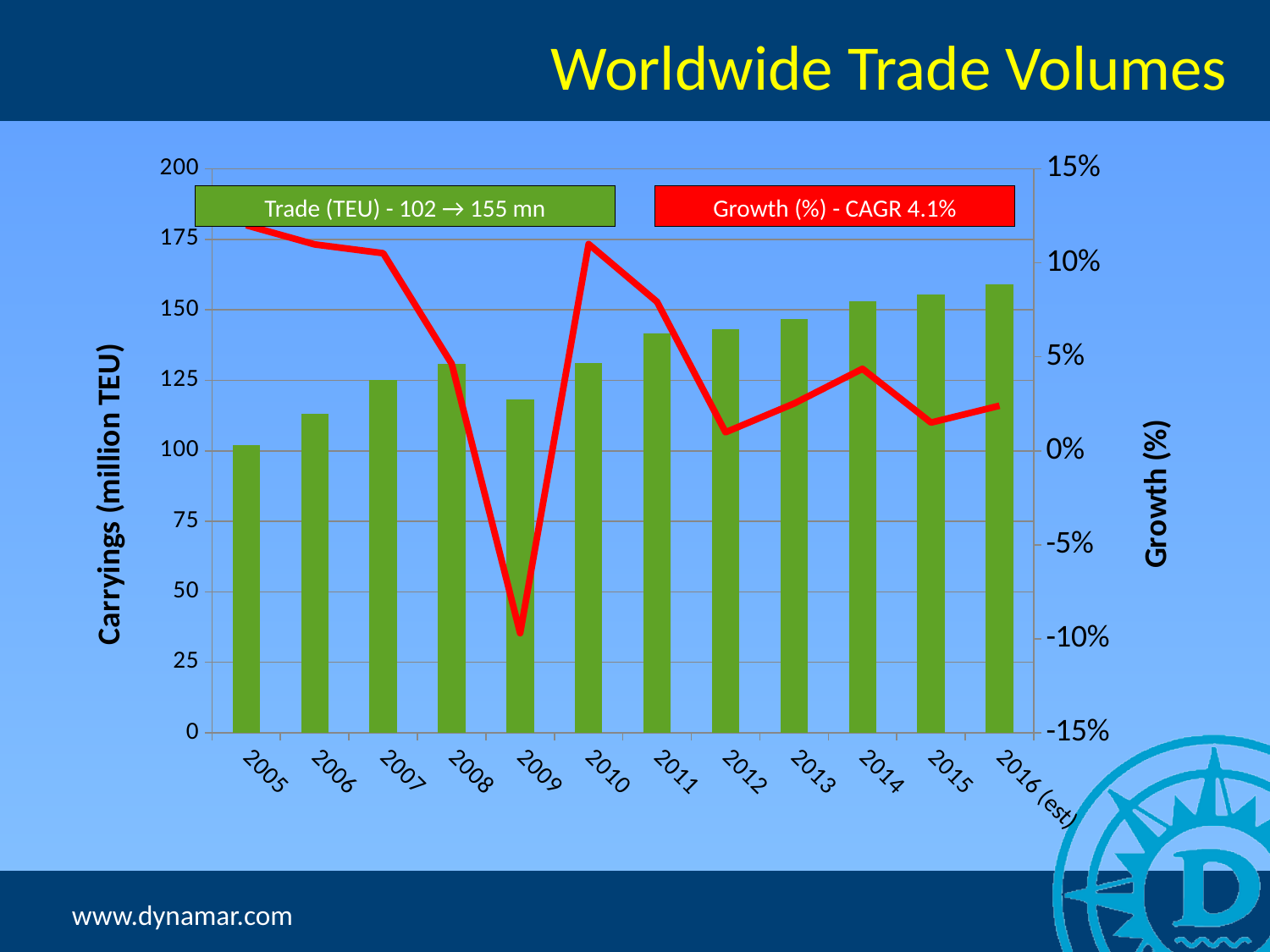
Do the Trade (TEU) bars generally rise or fall from 2005 to 2016 (est)? rise Is the Trade (TEU) value for 2016 (est) greater or less than 150 million TEU? greater Is the Growth (%) value for 2009 greater or less than -5%? less Which year has the highest Trade (TEU) bar? 2016 (est) What CAGR is stated in the legend for the Growth (%) series? 4.1% In which year does the Growth (%) line reach its lowest point? 2009 How many years (categories) are shown along the x axis? 12 How many series does the chart's legend list? 2 What kind of chart is shown on the slide? Combination bar and line chart Which year has the larger Trade (TEU) bar, 2008 or 2009? 2008 Which year has the lowest Trade (TEU) bar? 2005 What is the title of the chart on the slide? Worldwide Trade Volumes